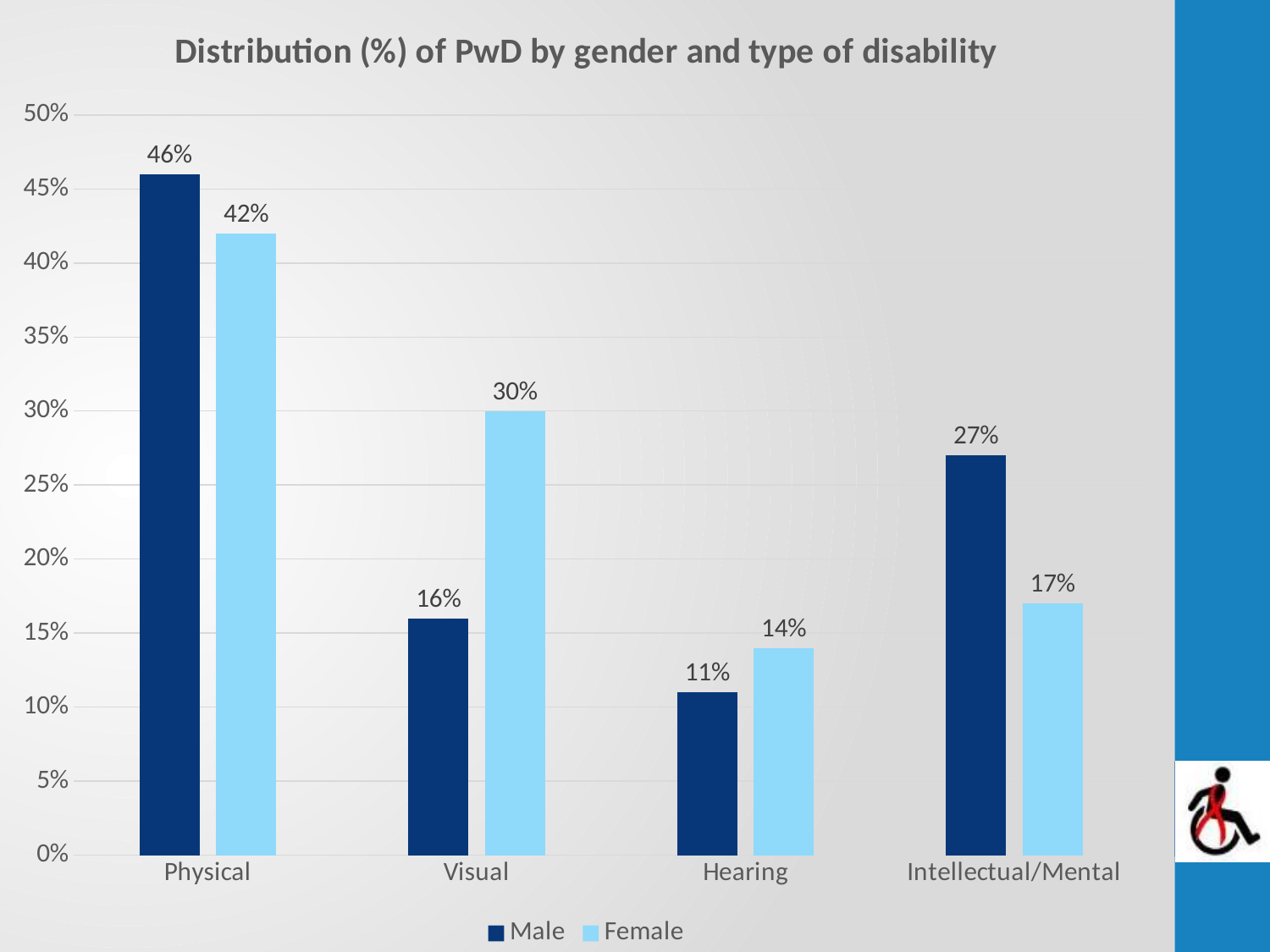
Which is larger for Visual disability, the Male value or the Female value? Female What is the title of the chart? Distribution (%) of PwD by gender and type of disability What is the Female value for Intellectual/Mental disability? 17% What is the difference between the Male and Female values for Intellectual/Mental disability? 10% What kind of chart is shown on the slide? Bar chart Which type of disability has the lowest Female value? Hearing What is the Male value for Physical disability? 46% What is the Female value for Visual disability? 30% How many series does the legend list? 2 Which type of disability has the highest Male value? Physical How many types of disability are shown on the x axis? 4 What is the Male value for Hearing disability? 11%